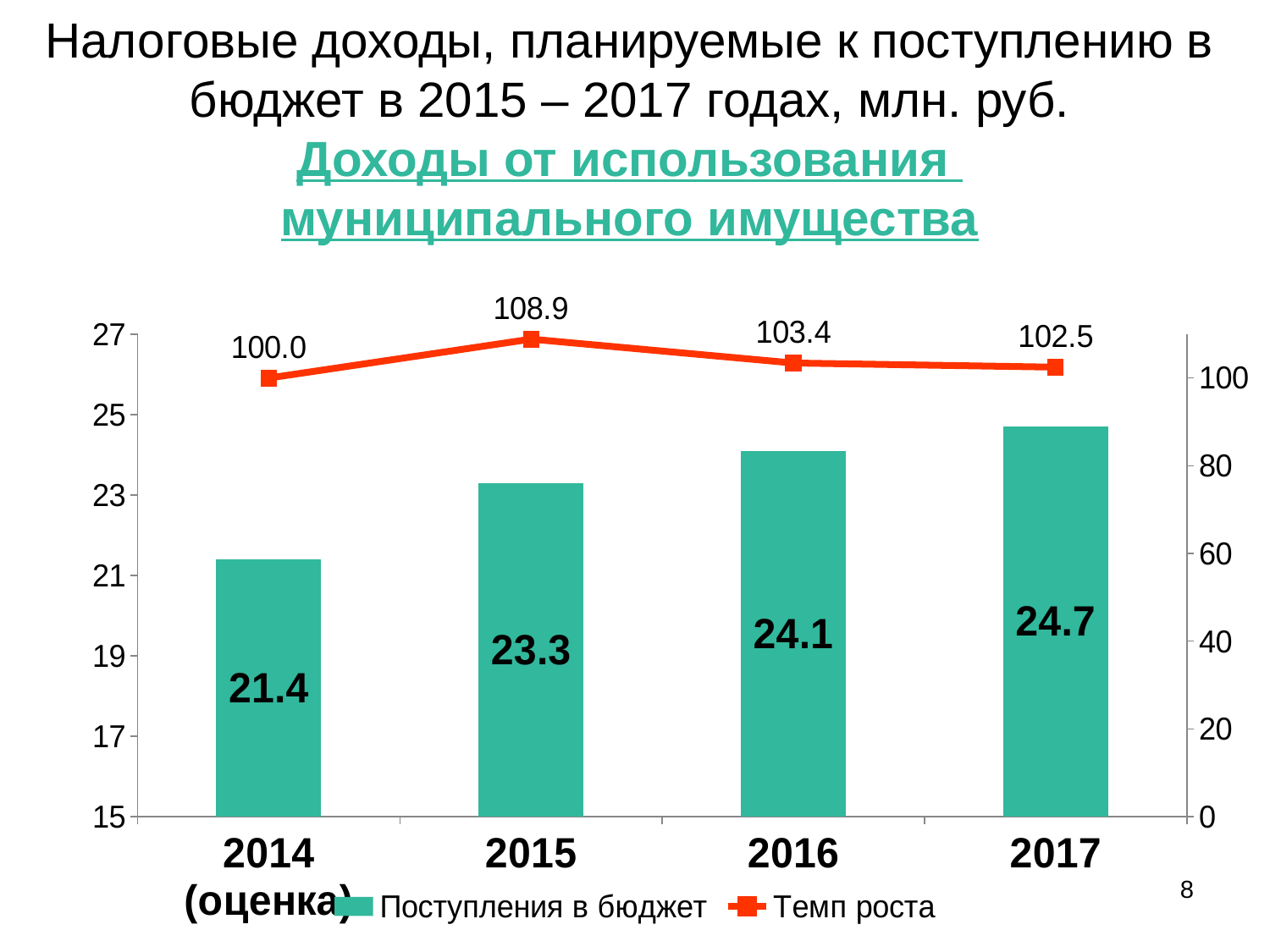
What is the value of "Поступления в бюджет" for 2015? 23.3 Which year has the lowest value of "Темп роста"? 2014 (оценка) What is the value of "Поступления в бюджет" for 2014 (оценка)? 21.4 What is the difference between "Поступления в бюджет" in 2017 and in 2014 (оценка)? 3.3 Do the values of "Поступления в бюджет" rise or fall from 2014 to 2017? rise Which is larger: "Темп роста" in 2016 or in 2017? 2016 What colour are the bars for "Поступления в бюджет"? teal (green) Which year has the highest value of "Поступления в бюджет"? 2017 How many series does the legend list? 2 Which year has the highest value of "Темп роста"? 2015 What is the value of "Темп роста" for 2016? 103.4 How many years are shown on the x axis? 4